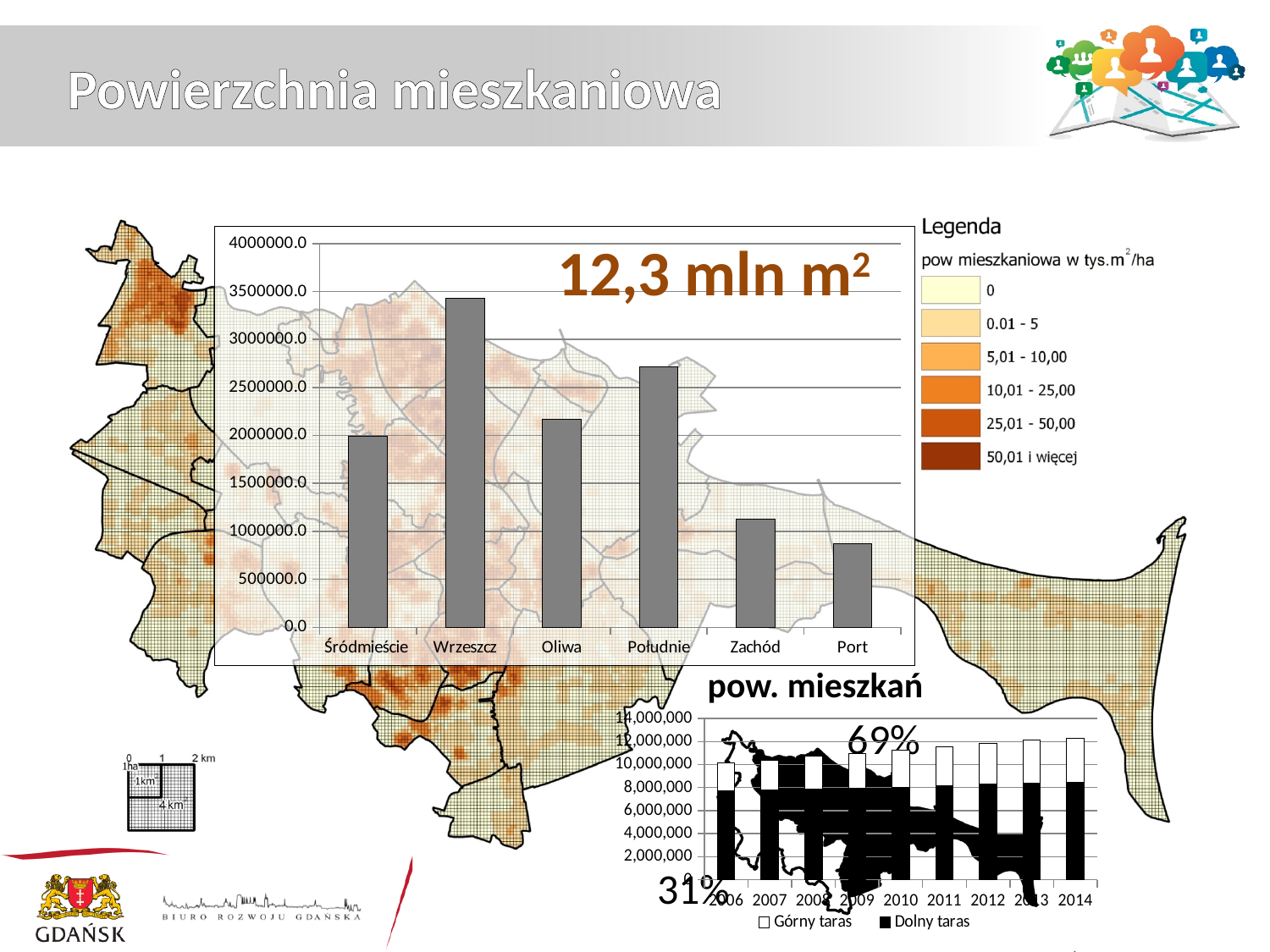
What kind of chart is the 'pow. mieszkań' chart at the bottom right? stacked bar chart How many series does the legend of the 'pow. mieszkań' chart list? 2 In the gray bar chart over the map, is the value for Wrzeszcz greater or less than 3000000.0? greater How many years are shown on the x axis of the 'pow. mieszkań' chart? 9 In the gray bar chart over the map, is the value for Południe greater or less than 2500000.0? greater In the gray bar chart over the map, which is larger, the value for Południe or the value for Oliwa? Południe In the gray bar chart over the map, which district has the highest bar? Wrzeszcz In the gray bar chart over the map, is the value for Śródmieście greater or less than 2500000.0? less In the 'pow. mieszkań' chart, do the total bar heights rise or fall from 2006 to 2014? rise In the gray bar chart over the map, how many districts are shown on the x axis? 6 In the gray bar chart over the map, which district has the lowest bar? Port